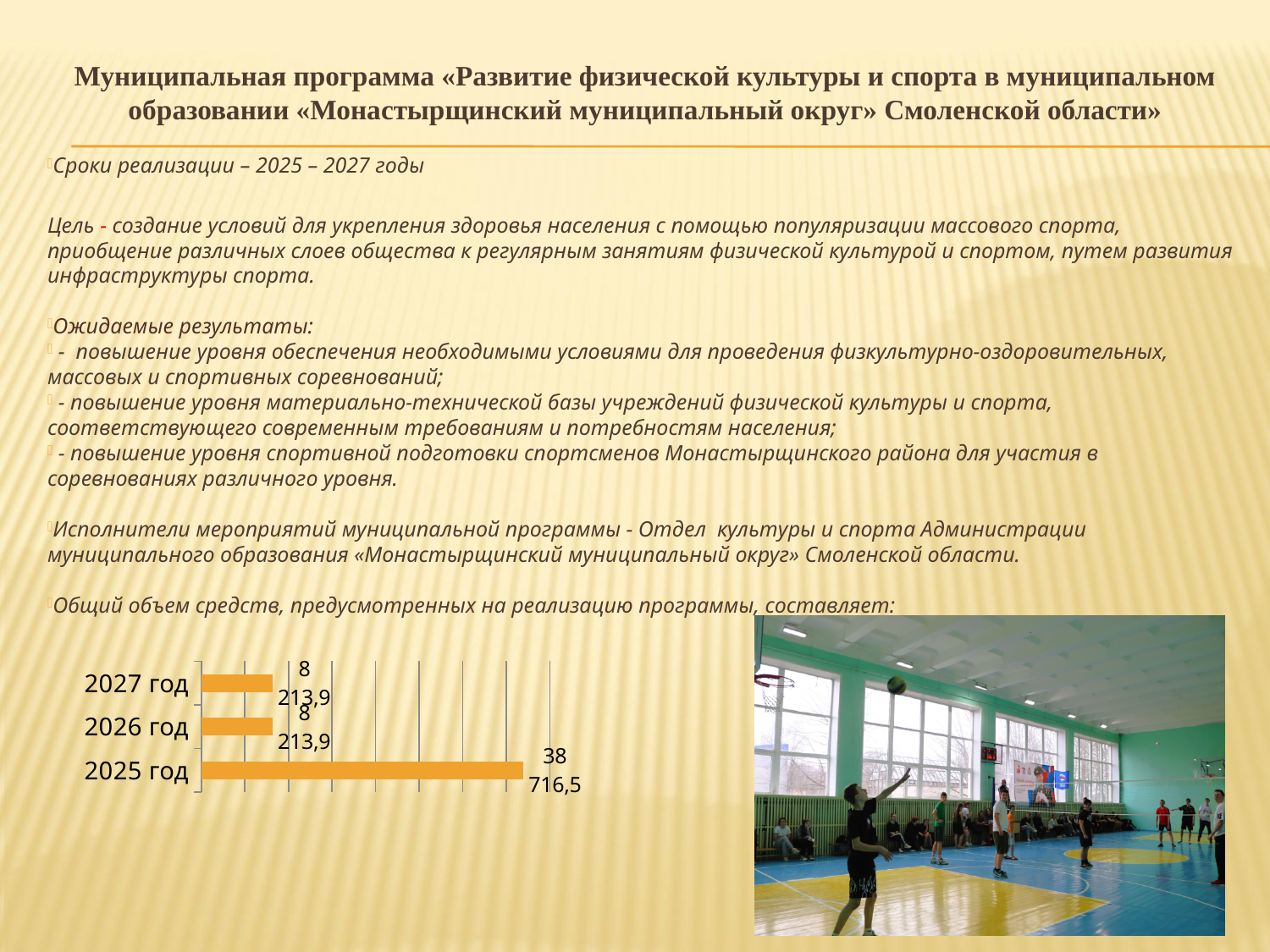
What data labels are printed next to the bar for 2027 год? 8 213,9 Which year has the longest bar in the chart? 2025 год What data labels are printed next to the bar for 2026 год? 8 213,9 How many categories (years) does the bar chart show? 3 Is the bar for 2025 год longer or shorter than the bar for 2027 год? longer Which year is listed at the top of the chart's category axis? 2027 год What colour are the bars in the chart? orange What data labels are printed next to the bar for 2025 год? 38 716,5 What kind of chart is shown at the bottom left of the slide? bar chart Which years in the chart have identical data labels? 2026 год and 2027 год